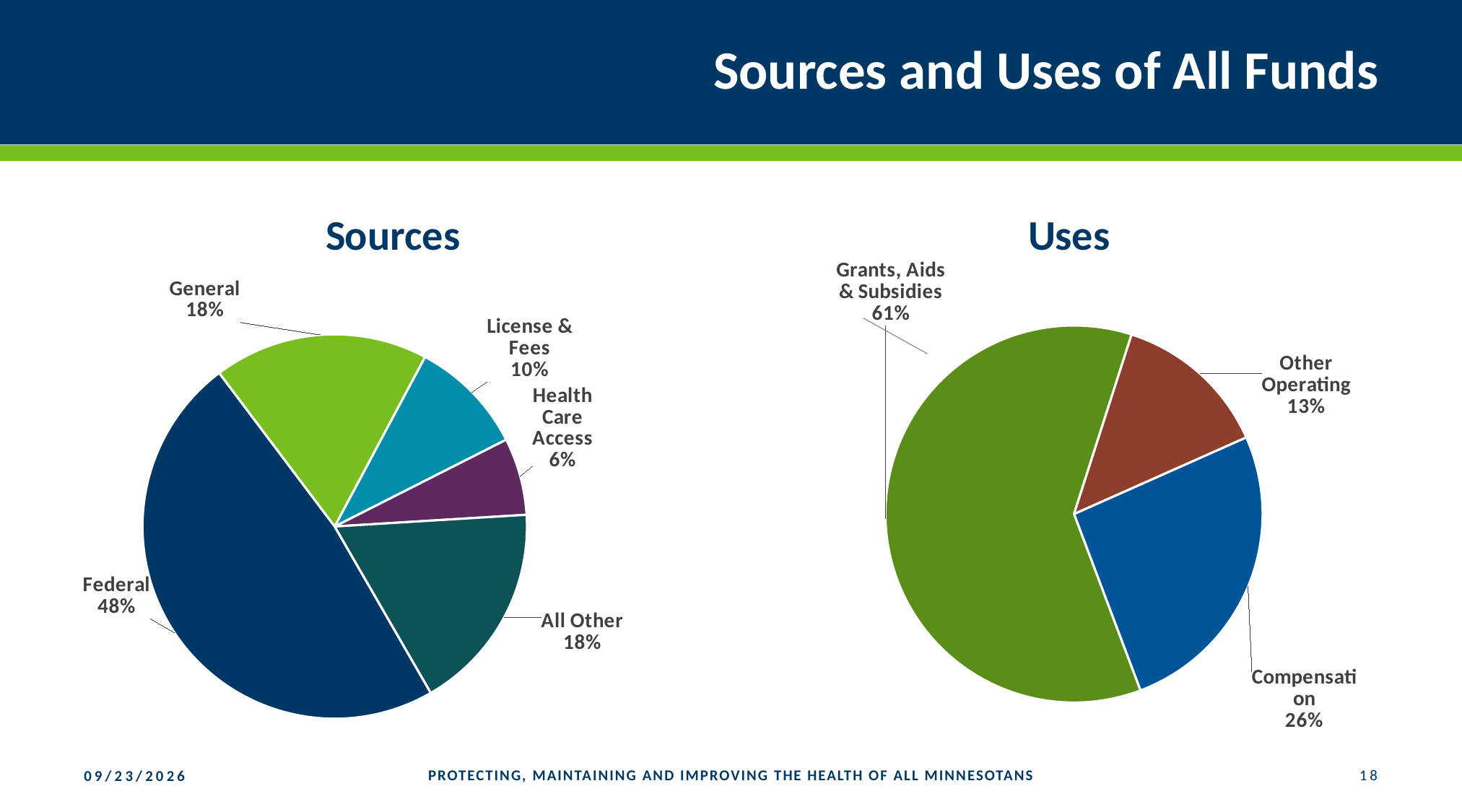
In the Sources chart, what share of funds comes from License & Fees? 10% In the Sources chart, which source has the largest share? Federal In the Uses chart, which use has the smallest share? Other Operating In the Sources chart, what share of funds comes from Federal? 48% In the Uses chart, what share of funds goes to Compensation? 26% In the Uses chart, what share of funds goes to Grants, Aids & Subsidies? 61% What kind of chart is the Uses chart? Pie chart In the Sources chart, how many slices does the pie have? 5 In the Sources chart, what is the difference between the Federal share and the General share? 30% In the Sources chart, which source has the smallest share? Health Care Access In the Sources chart, what share of funds comes from Health Care Access? 6% In the Uses chart, which is larger, Compensation or Other Operating? Compensation